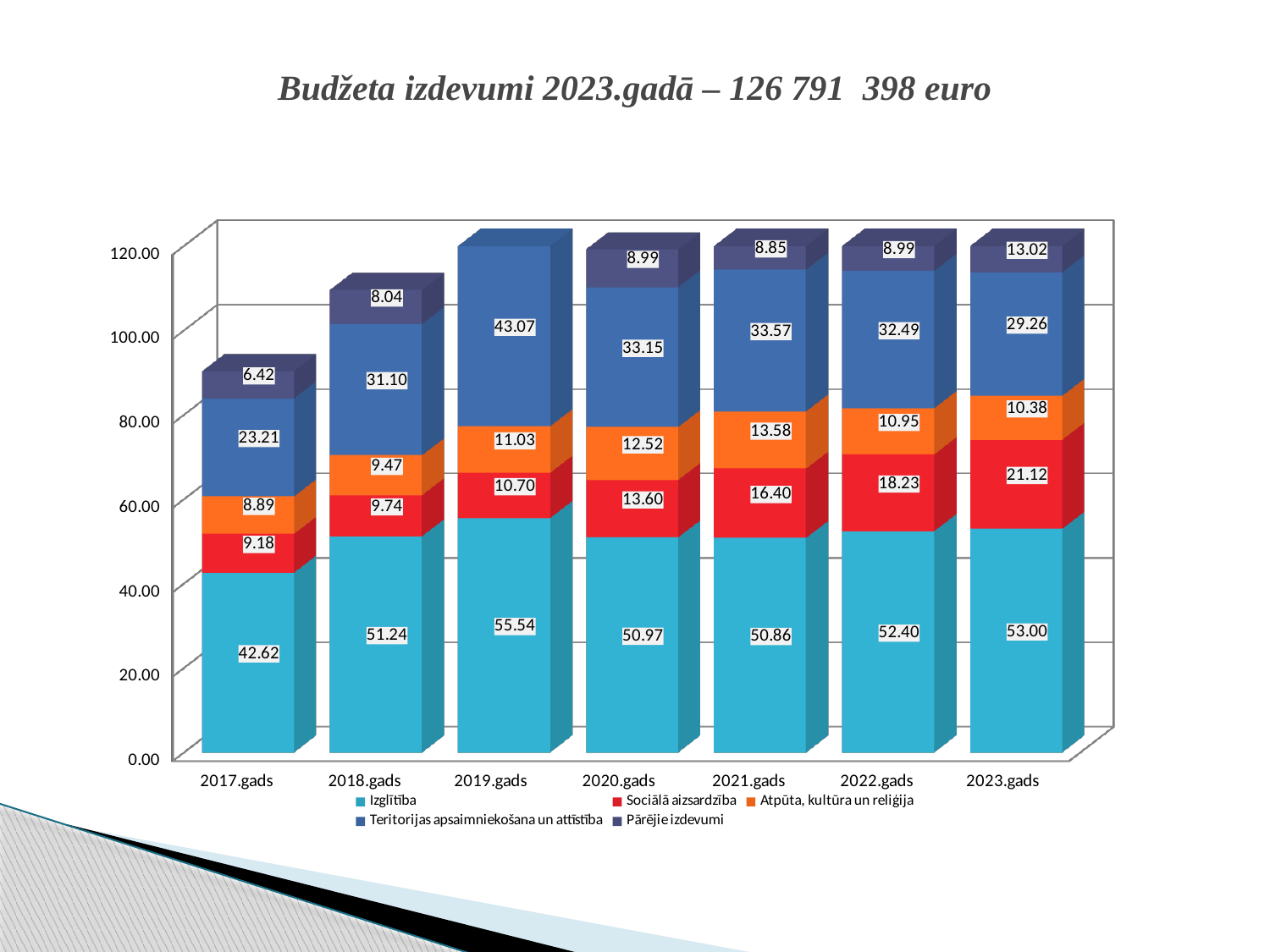
How many years are shown on the x axis? 7 Which is larger, the Atpūta, kultūra un reliģija value in 2021.gads or in 2022.gads? 2021.gads What kind of chart is shown on the slide? Stacked bar chart How many series does the legend list? 5 What is the difference between the Sociālā aizsardzība values for 2023.gads and 2017.gads? 11.94 In which year is the Izglītība value highest? 2019.gads What is the value for Sociālā aizsardzība in 2021.gads? 16.40 What is the value for Teritorijas apsaimniekošana un attīstība in 2019.gads? 43.07 What is the total of the stacked bar for 2023.gads? 126.78 In which year is the Izglītība value lowest? 2017.gads What is the value for Pārējie izdevumi in 2017.gads? 6.42 What is the value for Izglītība in 2023.gads? 53.00